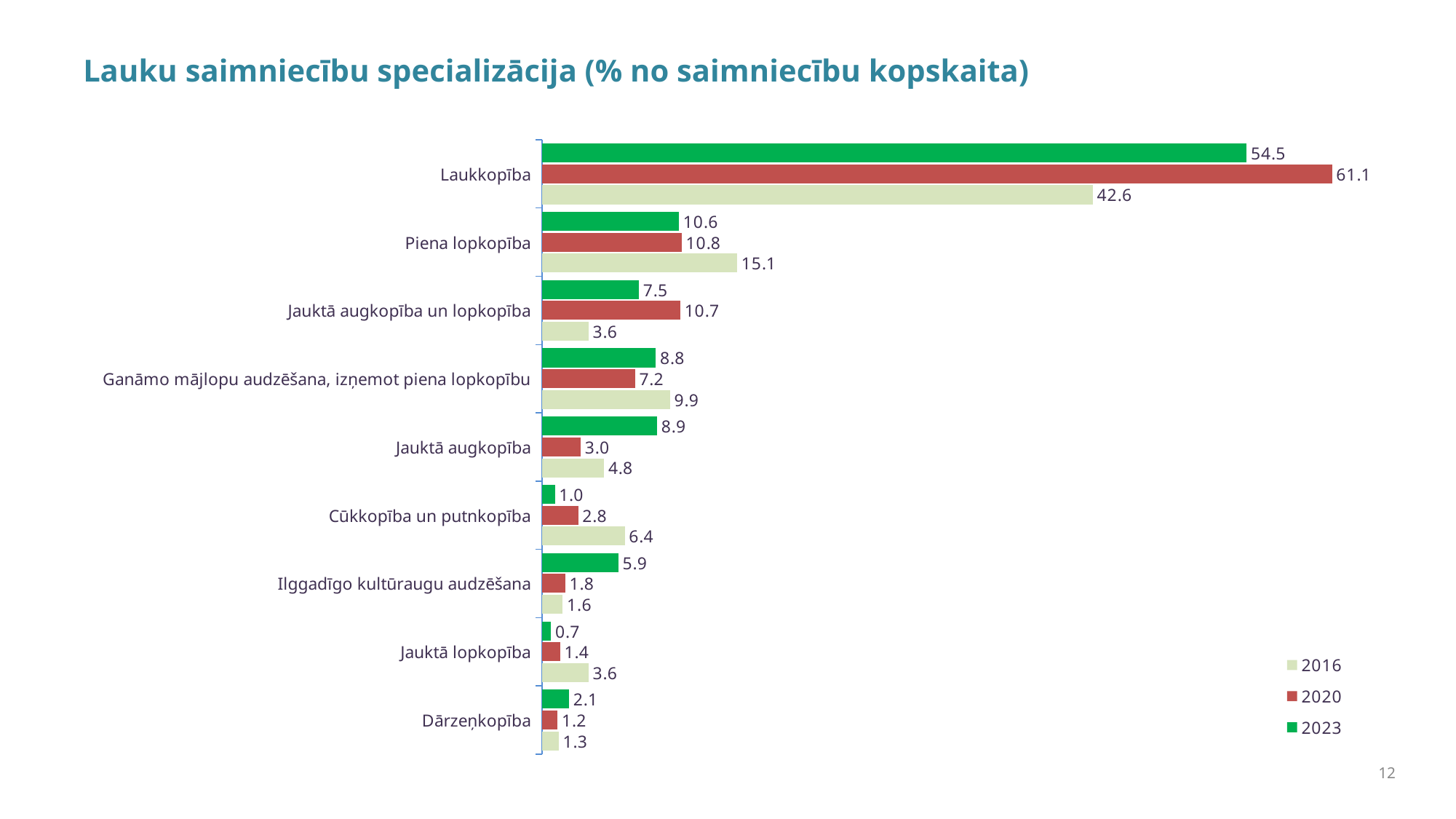
How many series does the legend list? 3 What is the value for Laukkopība in 2020? 61.1 How many categories are shown on the chart? 9 Which category has the lowest value in 2023? Jauktā lopkopība What is the title of the chart? Lauku saimniecību specializācija (% no saimniecību kopskaita) What is the value for Jauktā augkopība in 2023? 8.9 What is the value for Piena lopkopība in 2016? 15.1 Which is larger for Cūkkopība un putnkopība: the 2016 value or the 2023 value? 2016 What kind of chart is shown on the slide? Bar chart What is the difference between the 2020 and 2016 values for Laukkopība? 18.5 Which category has the highest value in 2023? Laukkopība What is the difference between the 2023 and 2020 values for Ilggadīgo kultūraugu audzēšana? 4.1